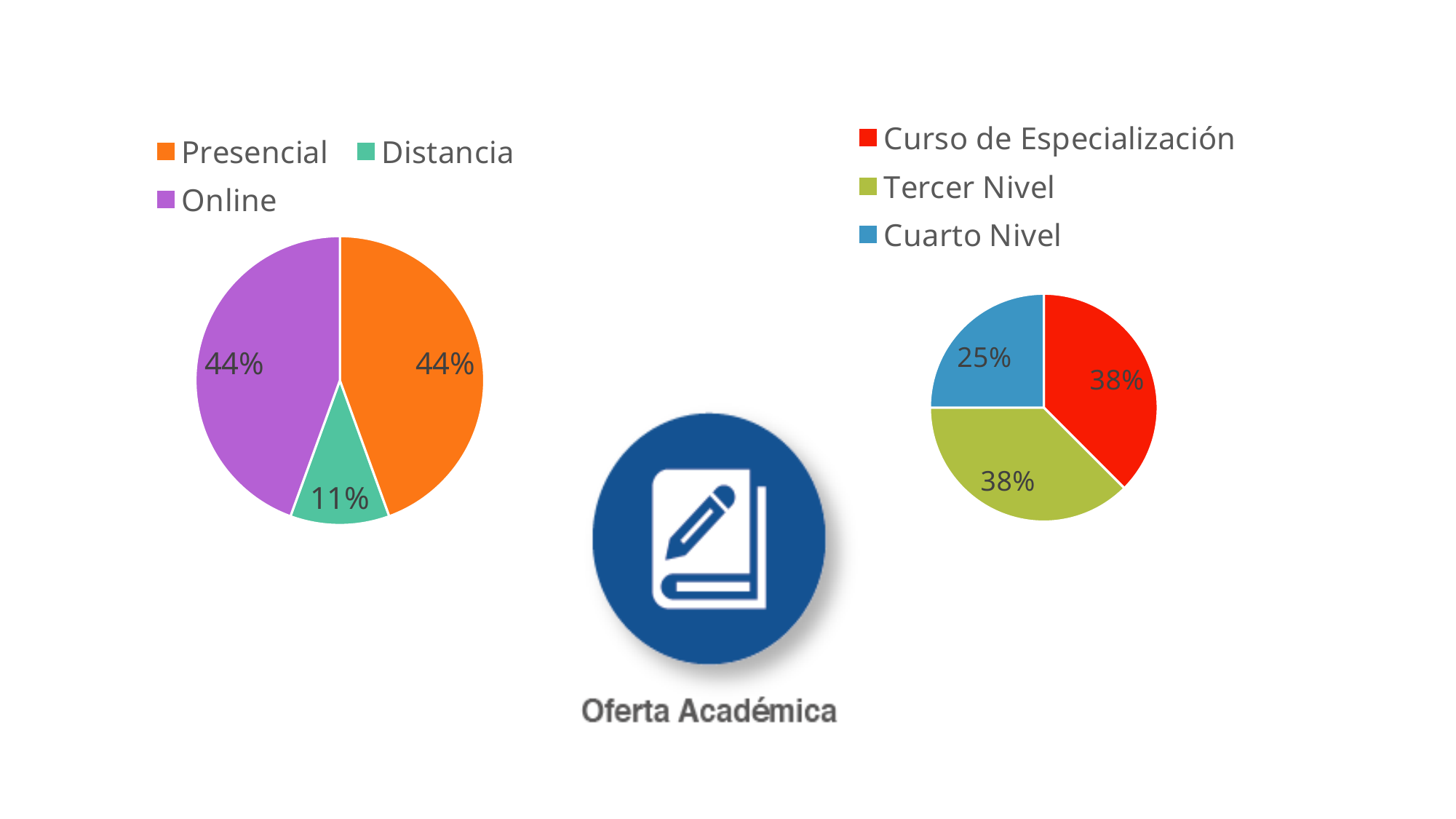
In the right pie chart, what colour is the Tercer Nivel slice? Green In the right pie chart, what share does Cuarto Nivel have? 25% What type of chart is the right chart? Pie chart In the left pie chart, what share does Presencial have? 44% In the left pie chart, what is the difference between the Online share and the Distancia share? 33% In the right pie chart, which category has the smallest share? Cuarto Nivel In the right pie chart, what is the difference between the Curso de Especialización share and the Cuarto Nivel share? 13% In the left pie chart, which category has the smallest share? Distancia In the right pie chart, what share does Tercer Nivel have? 38% In the left pie chart, which is larger, Presencial or Distancia? Presencial In the left pie chart, how many slices are there? 3 In the left pie chart, what share does Distancia have? 11%